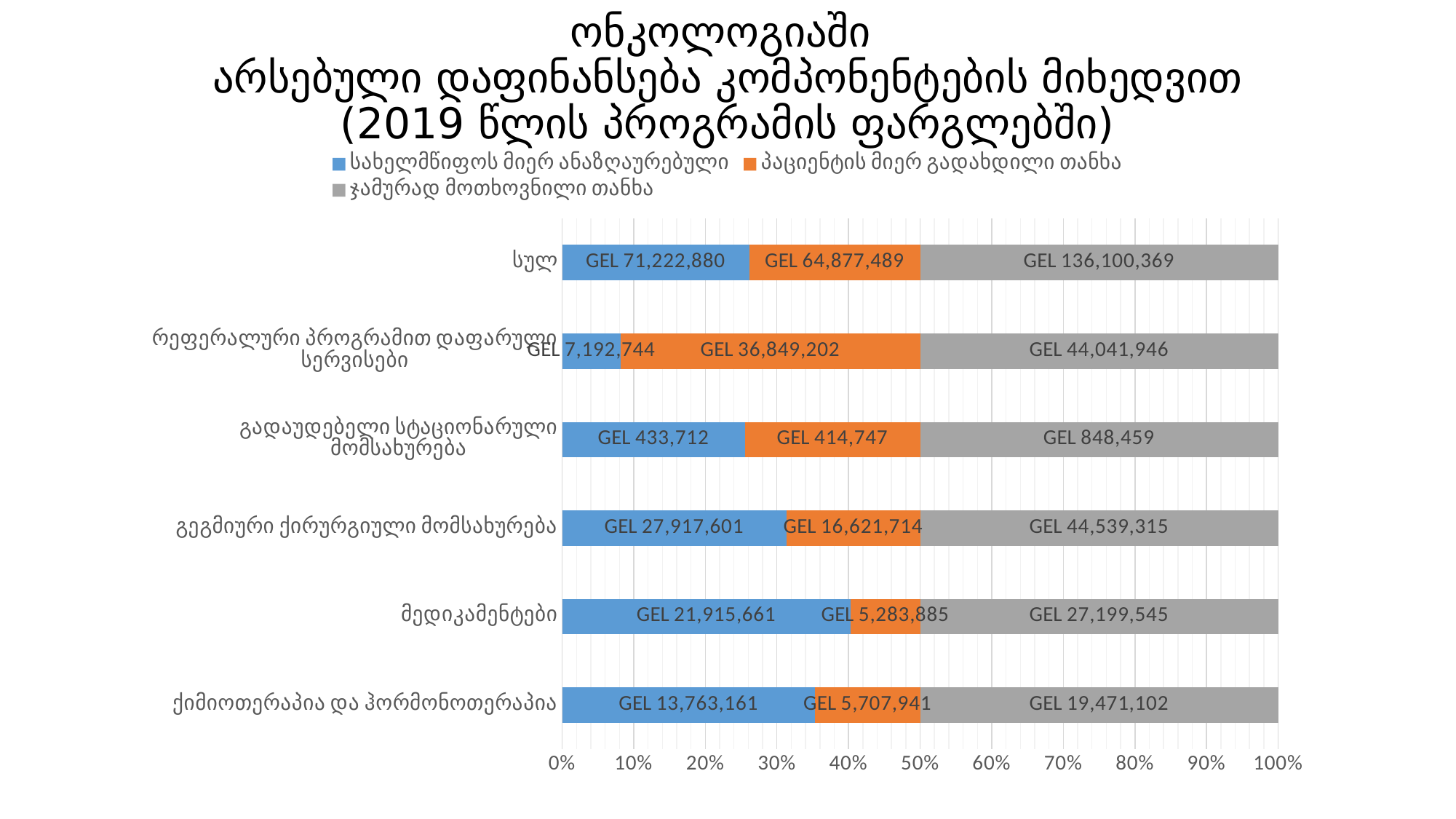
How many series does the legend list? 3 What is the value of სახელმწიფოს მიერ ანაზღაურებული for სულ? GEL 71,222,880 What is the value of ჯამურად მოთხოვნილი თანხა for გადაუდებელი სტაციონარული მომსახურება? GEL 848,459 Excluding the სულ row, which category has the highest value for სახელმწიფოს მიერ ანაზღაურებული? გეგმიური ქირურგიული მომსახურება What kind of chart is shown on the slide? bar chart What is the value of პაციენტის მიერ გადახდილი თანხა for ქიმიოთერაპია და ჰორმონოთერაპია? GEL 5,707,941 What is the difference between სახელმწიფოს მიერ ანაზღაურებული and პაციენტის მიერ გადახდილი თანხა for მედიკამენტები? GEL 16,631,776 How many categories (bars) are shown on the chart? 6 For რეფერალური პროგრამით დაფარული სერვისები, which is larger: სახელმწიფოს მიერ ანაზღაურებული or პაციენტის მიერ გადახდილი თანხა? პაციენტის მიერ გადახდილი თანხა Excluding the სულ row, which category has the lowest value for ჯამურად მოთხოვნილი თანხა? გადაუდებელი სტაციონარული მომსახურება What is the value of პაციენტის მიერ გადახდილი თანხა for რეფერალური პროგრამით დაფარული სერვისები? GEL 36,849,202 Is the share of the bar taken by სახელმწიფოს მიერ ანაზღაურებული for რეფერალური პროგრამით დაფარული სერვისები greater or less than 10%? less